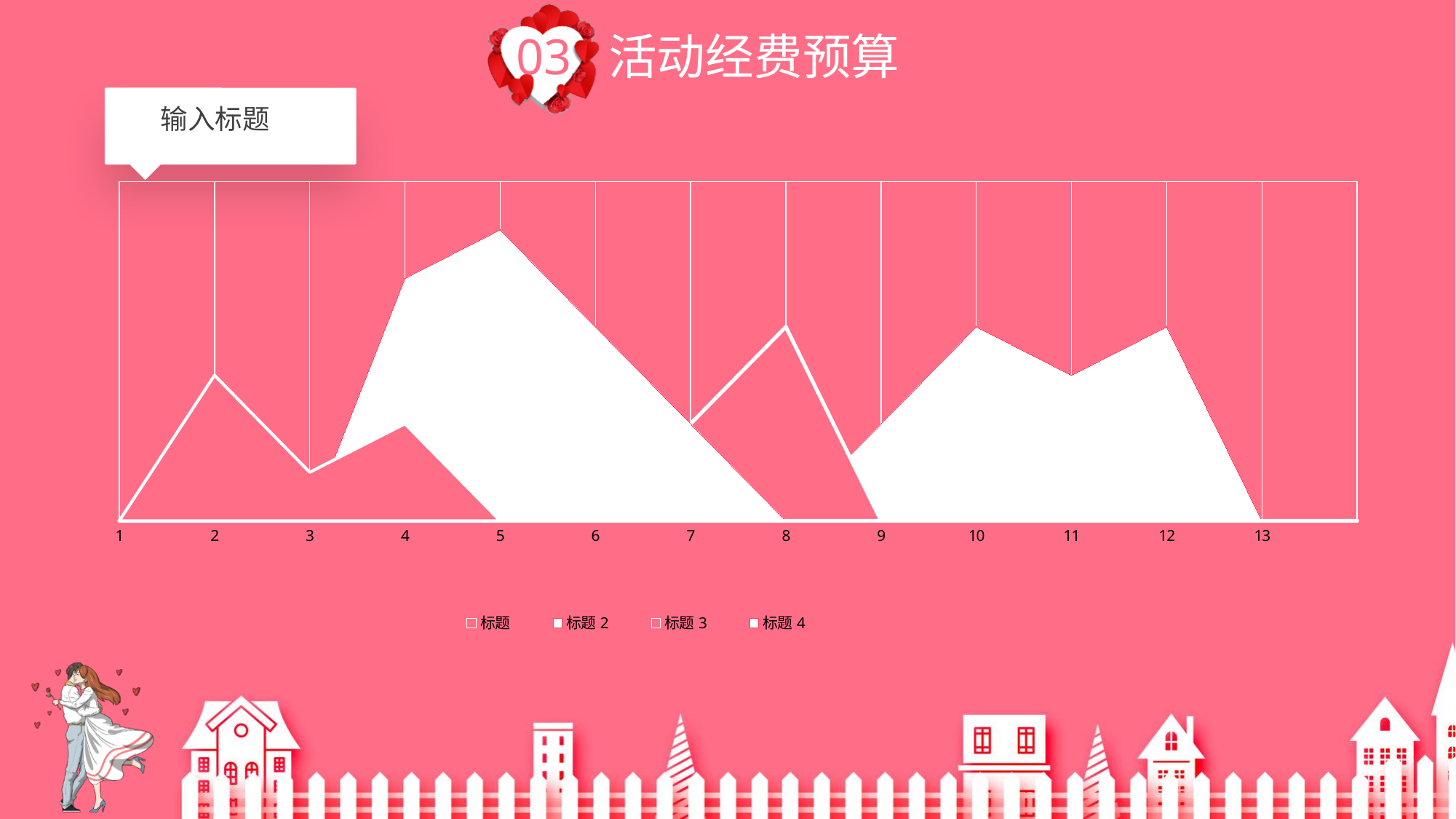
How many series does the chart's legend list? 4 At which x-axis category does the plotted area reach its highest point? 5 What kind of chart is shown on the slide? area chart How many categories are shown along the x axis of the chart? 13 What is the last x-axis category label on the chart? 13 What is the first x-axis category label on the chart? 1